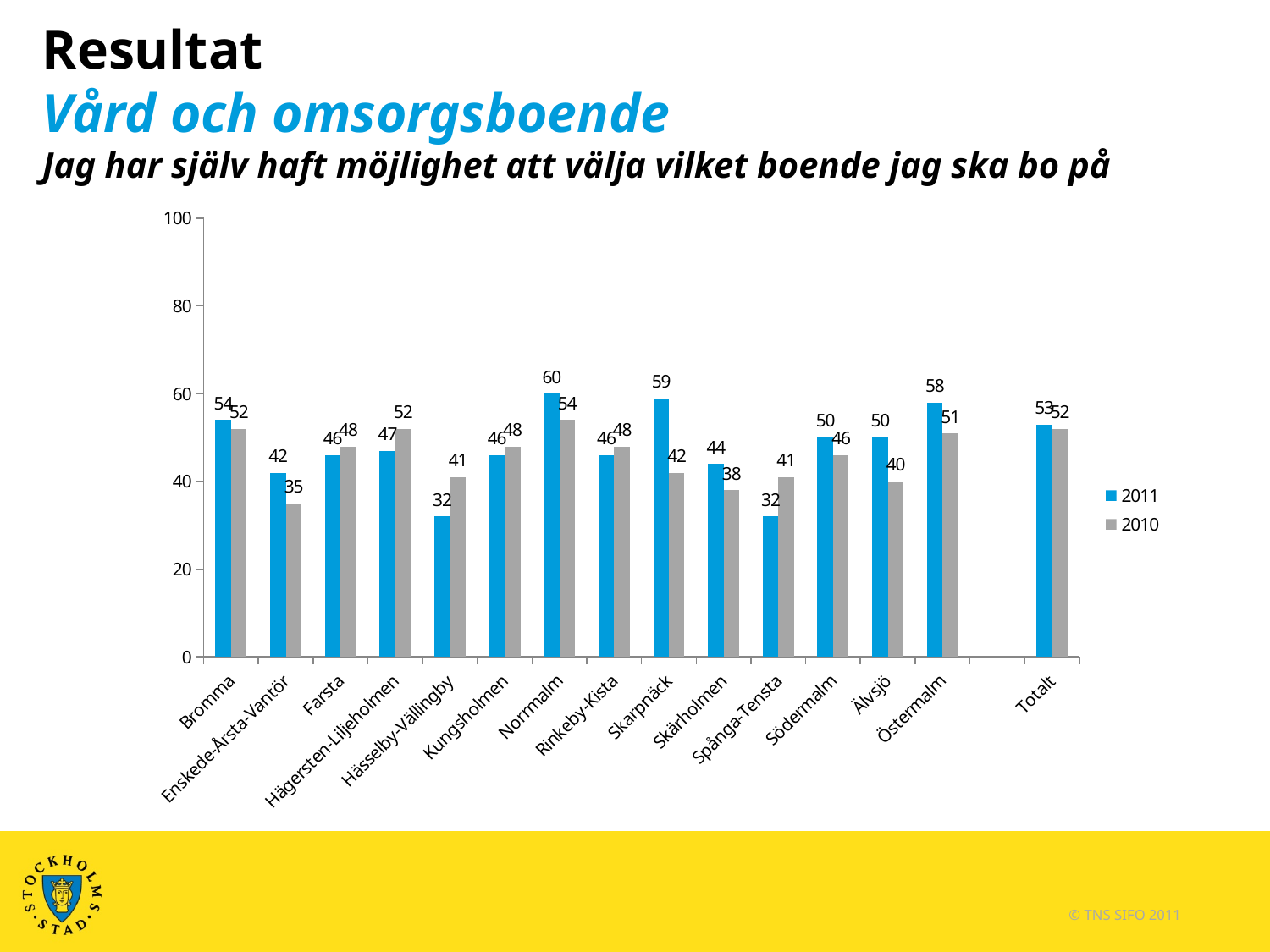
What kind of chart is shown on the slide? bar chart What is the 2010 value for Enskede-Årsta-Vantör? 35 Which colour represents the 2010 series in the legend? grey What is the difference between the 2011 and 2010 values for Skarpnäck? 17 What is the 2011 value for Totalt? 53 How many categories are shown on the x axis? 15 Which category has the highest 2011 value? Norrmalm Is the 2011 value for Östermalm greater or less than 40? greater Which category has the lowest 2010 value? Enskede-Årsta-Vantör What is the 2011 value for Norrmalm? 60 How many series does the legend list? 2 Which is larger for Hägersten-Liljeholmen, the 2011 value or the 2010 value? 2010